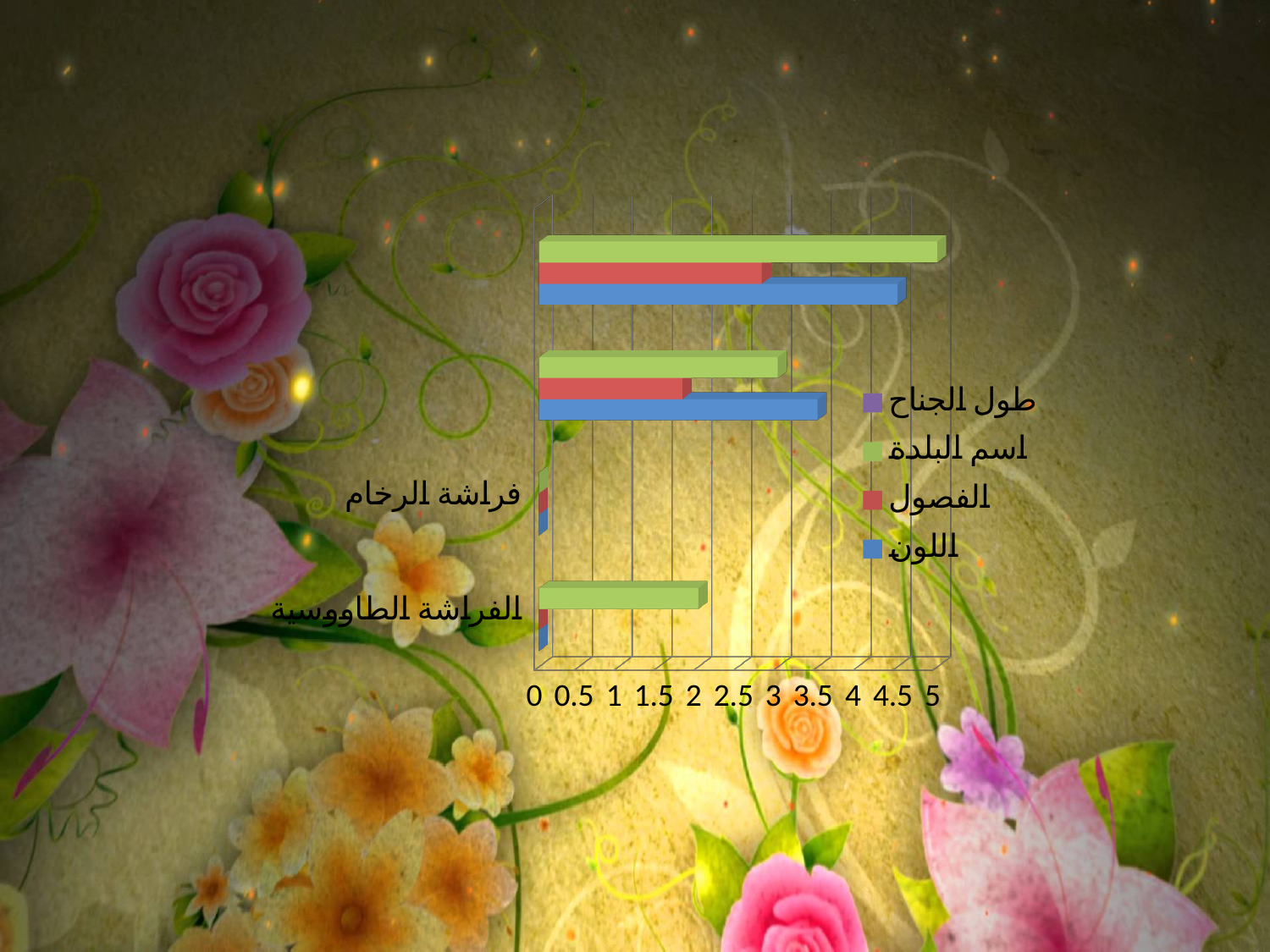
Is the value of اللون for فراشة الرخام greater or less than 0.5? less Which series is shown in green in the legend? اسم البلدة What is the highest value shown on the horizontal axis? 5 How many series does the legend list? 4 For الفراشة الطاووسية, which is larger: the value of اسم البلدة or the value of اللون? اسم البلدة What kind of chart is shown on the slide? bar chart Is the value of اسم البلدة for الفراشة الطاووسية greater or less than 1? greater Is the value of اسم البلدة for الفراشة الطاووسية greater or less than 3? less Which series is shown in blue in the legend? اللون For الفراشة الطاووسية, which series has the highest value? اسم البلدة How many category groups of bars are plotted in the chart? 4